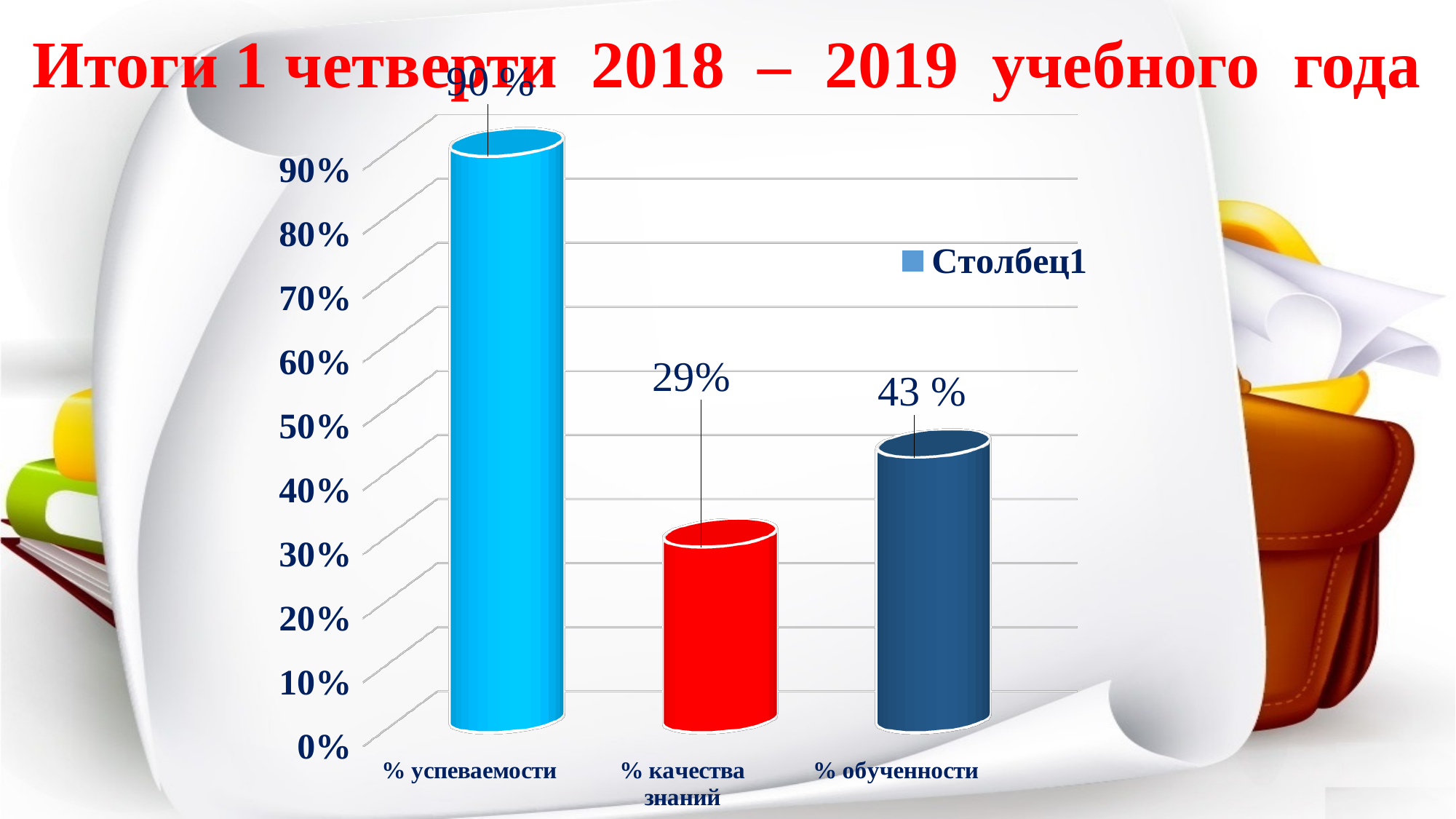
Is the value for % качества знаний greater or less than 40%? less What kind of chart is shown on the slide? bar chart How many categories are shown on the x axis? 3 Is the value for % успеваемости greater or less than 80%? greater What is the value for % качества знаний? 29% Which category has the highest value? % успеваемости Which category has the lowest value? % качества знаний What is the value for % обученности? 43 % What is the value for % успеваемости? 90 % Which is larger, the value for % обученности or the value for % качества знаний? % обученности What series name does the legend list? Столбец1 What is the difference between the values for % обученности and % качества знаний? 14%